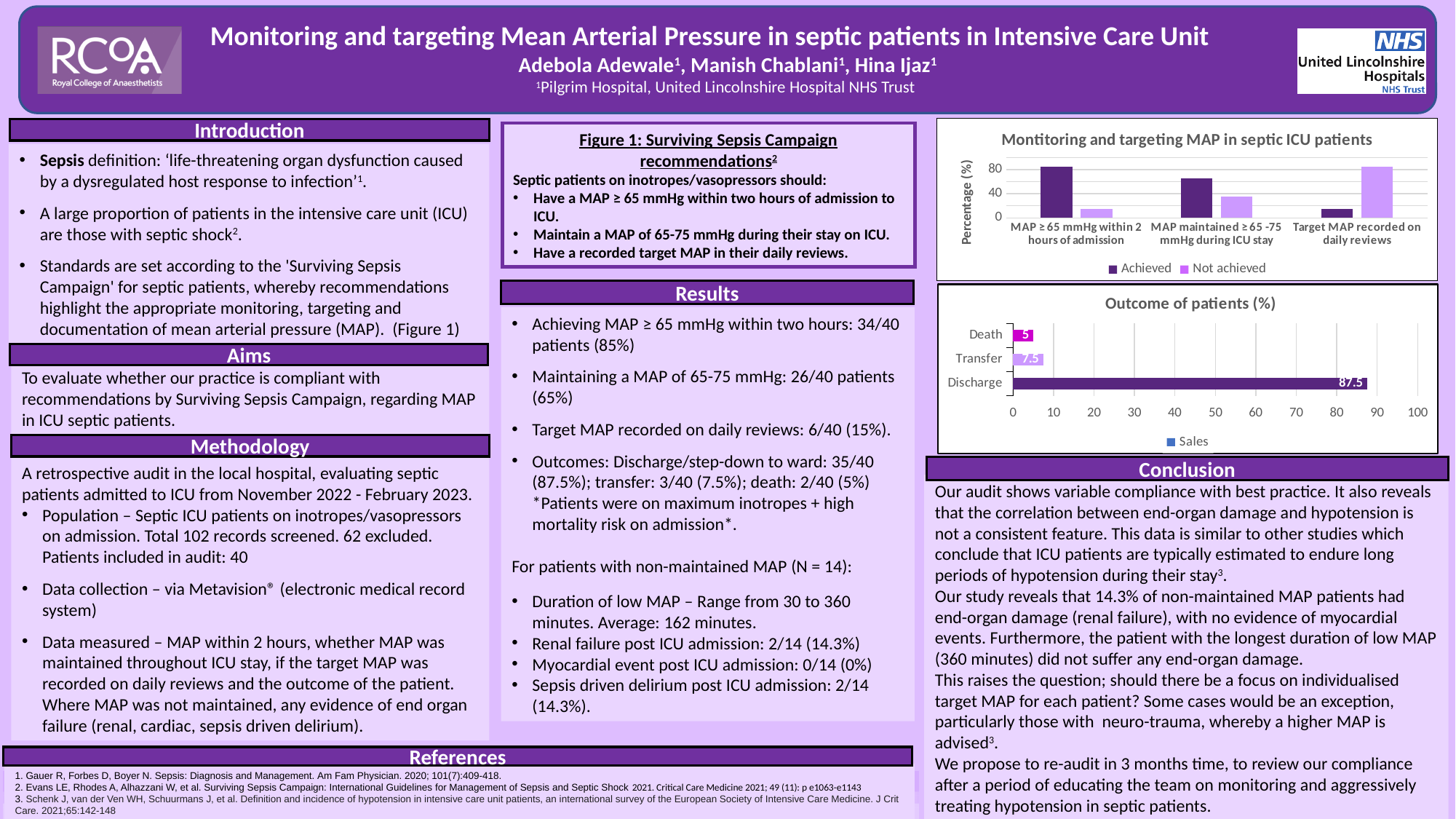
In the 'Monitoring and targeting MAP in septic ICU patients' chart, is the Achieved value for 'Target MAP recorded on daily reviews' greater or less than 40? less In the 'Outcome of patients (%)' chart, what is the value for Discharge? 87.5 In the 'Monitoring and targeting MAP in septic ICU patients' chart, which is larger for 'MAP maintained ≥ 65 -75 mmHg during ICU stay': Achieved or Not achieved? Achieved In the 'Outcome of patients (%)' chart, which category has the highest value? Discharge In the 'Outcome of patients (%)' chart, what is the value for Transfer? 7.5 In the 'Monitoring and targeting MAP in septic ICU patients' chart, is the Achieved value for 'MAP ≥ 65 mmHg within 2 hours of admission' greater or less than 40? greater In the 'Outcome of patients (%)' chart, what is the value for Death? 5 In the 'Outcome of patients (%)' chart, which category has the lowest value? Death What type of chart is the 'Outcome of patients (%)' chart? Bar chart In the 'Monitoring and targeting MAP in septic ICU patients' chart, how many series does the legend list? 2 In the 'Outcome of patients (%)' chart, what is the difference between the Discharge and Transfer values? 80 In the 'Outcome of patients (%)' chart, how many categories are shown? 3